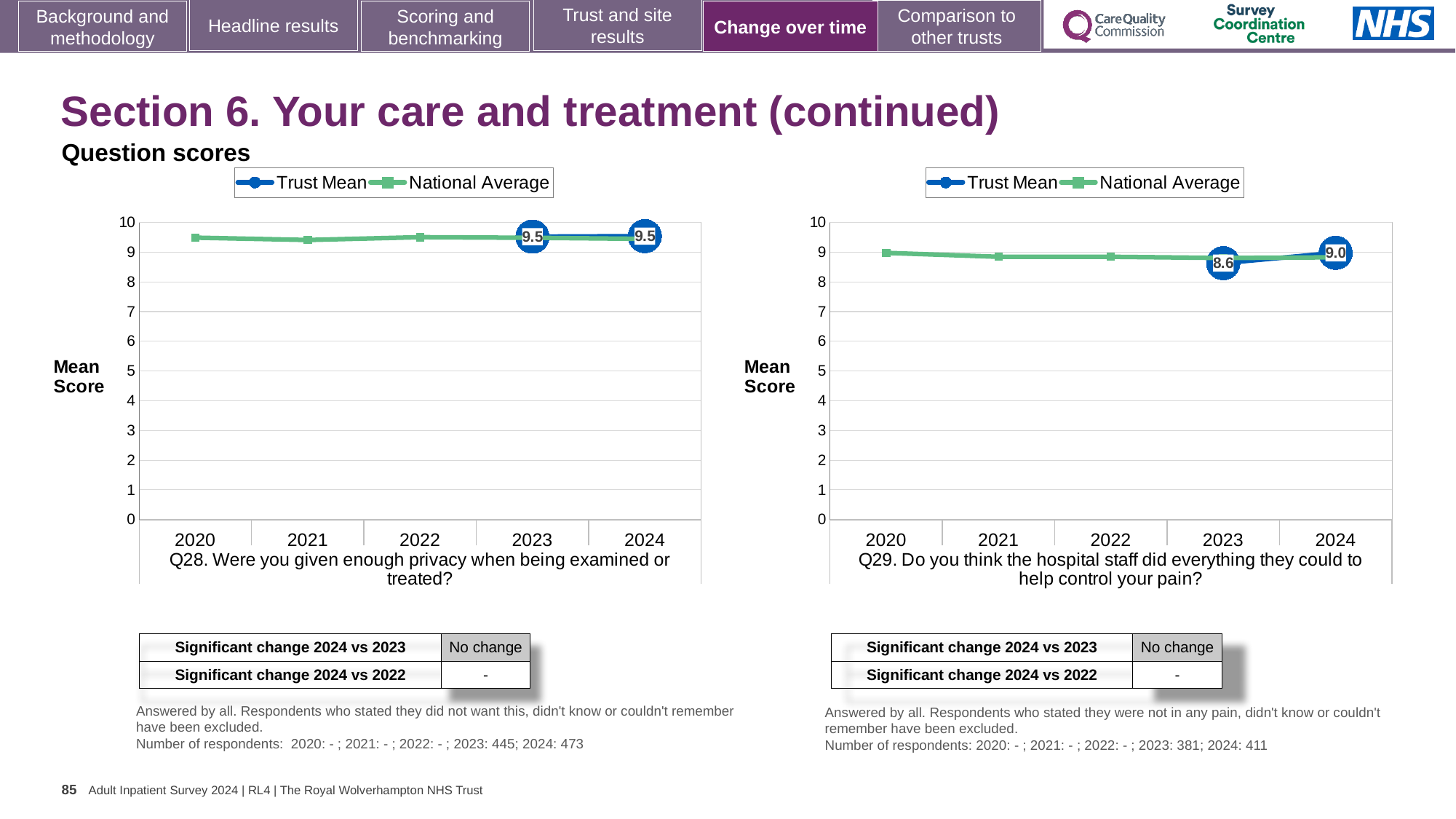
How many series does the legend of the Q29 chart (right) list? 2 On the Q29 chart (right), which year has the higher Trust Mean, 2023 or 2024? 2024 On the Q28 chart (left), what is the Trust Mean score for 2024? 9.5 On the Q29 chart (right), is the National Average for 2020 greater or less than 8? greater On the Q29 chart (right), did the Trust Mean rise or fall from 2023 to 2024? rise On the Q29 chart (right), by how much did the Trust Mean change from 2023 to 2024? 0.4 What type of chart is used for Q28 (left)? line chart On the Q28 chart (left), is the National Average for 2021 greater or less than 9? greater On the Q28 chart (left), what is the Trust Mean score for 2023? 9.5 On the Q29 chart (right), what is the Trust Mean score for 2023? 8.6 On the Q29 chart (right), what is the Trust Mean score for 2024? 9.0 How many years are shown on the x axis of the Q28 chart (left)? 5